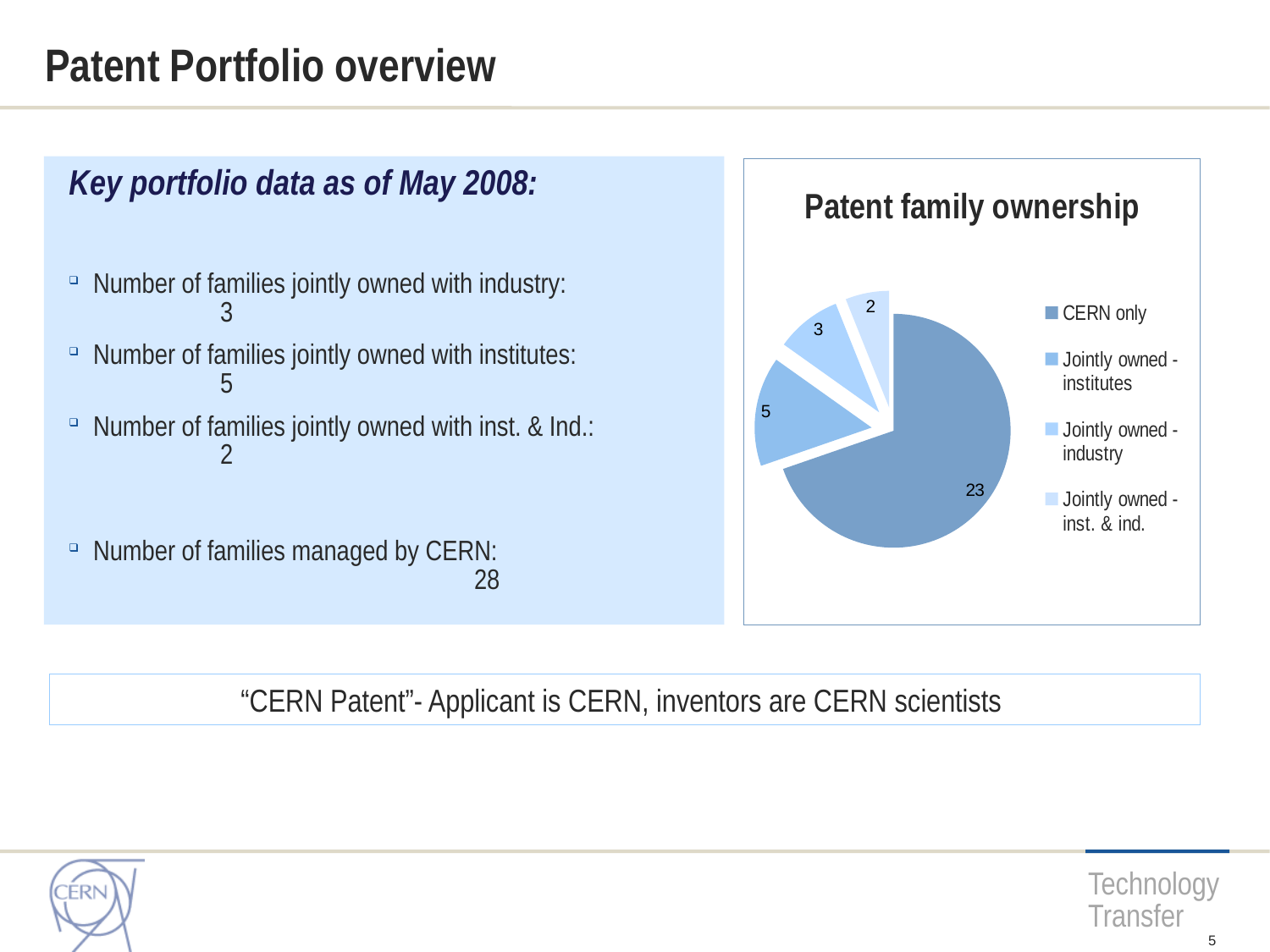
What is the value of the 'Jointly owned - inst. & ind.' slice? 2 Which is larger: 'Jointly owned - institutes' or 'Jointly owned - industry'? Jointly owned - institutes What is the title of the chart? Patent family ownership How many slices does the pie chart have? 4 What is the value of the 'CERN only' slice? 23 What type of chart is shown on the slide? Pie chart Which category has the largest slice in the pie chart? CERN only What is the value of the 'Jointly owned - institutes' slice? 5 What is the value of the 'Jointly owned - industry' slice? 3 Which category has the smallest slice in the pie chart? Jointly owned - inst. & ind. How many entries does the chart legend list? 4 What is the difference between the 'CERN only' value and the 'Jointly owned - institutes' value? 18